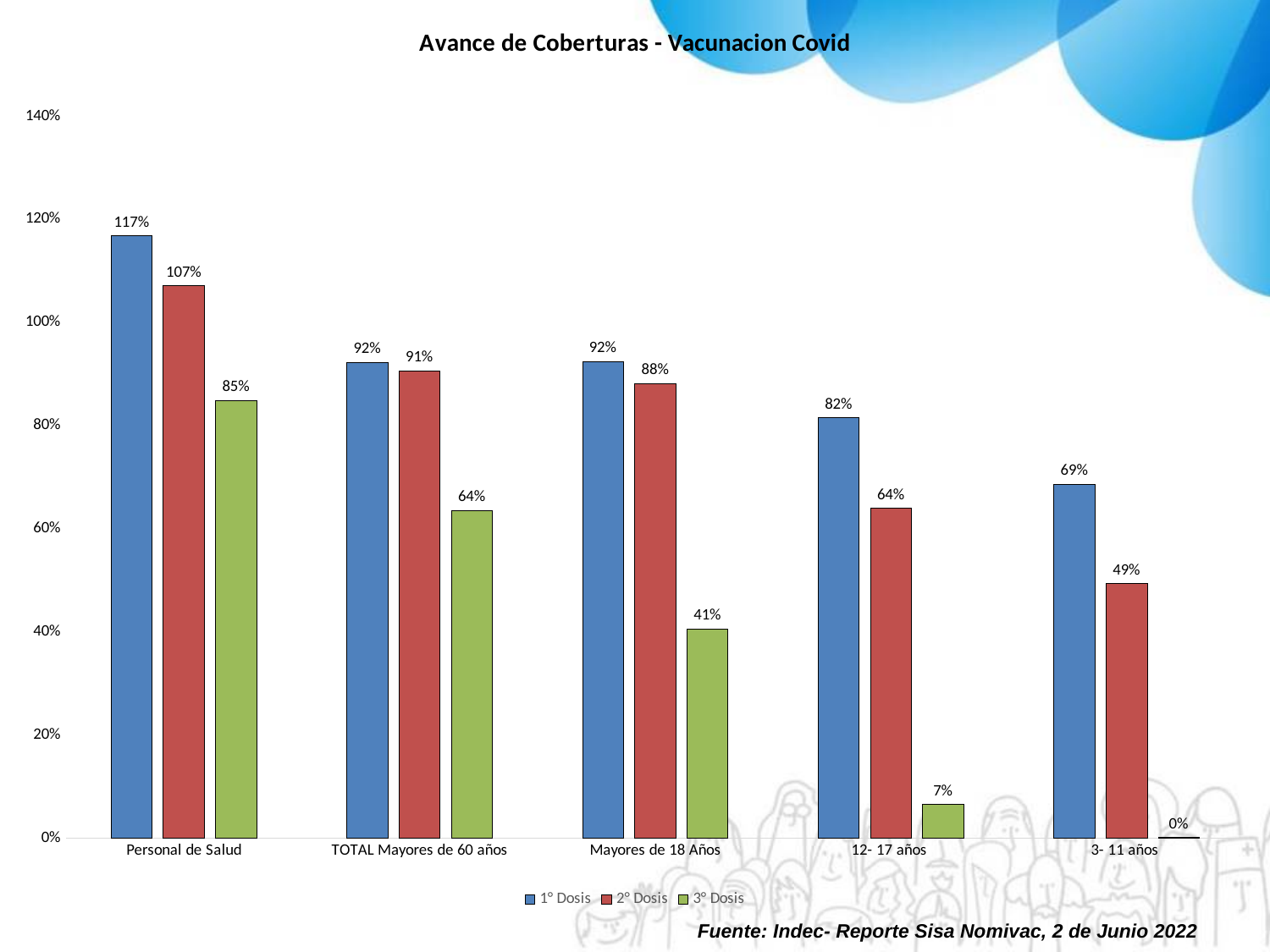
Which is larger: the 3° Dosis value for TOTAL Mayores de 60 años or the 3° Dosis value for Mayores de 18 Años? TOTAL Mayores de 60 años Do the 2° Dosis values rise or fall from left to right across the categories? Fall Which category has the lowest 3° Dosis value? 3- 11 años What kind of chart is shown on the slide? Bar chart What is the 2° Dosis value for 3- 11 años? 49% Which category has the highest 1° Dosis value? Personal de Salud What is the title of the chart? Avance de Coberturas - Vacunacion Covid What is the 3° Dosis value for Mayores de 18 Años? 41% What is the difference between the 1° Dosis and 2° Dosis values for 12- 17 años? 18% How many series does the legend list? 3 What is the 1° Dosis value for Personal de Salud? 117% How many categories are shown on the x axis? 5